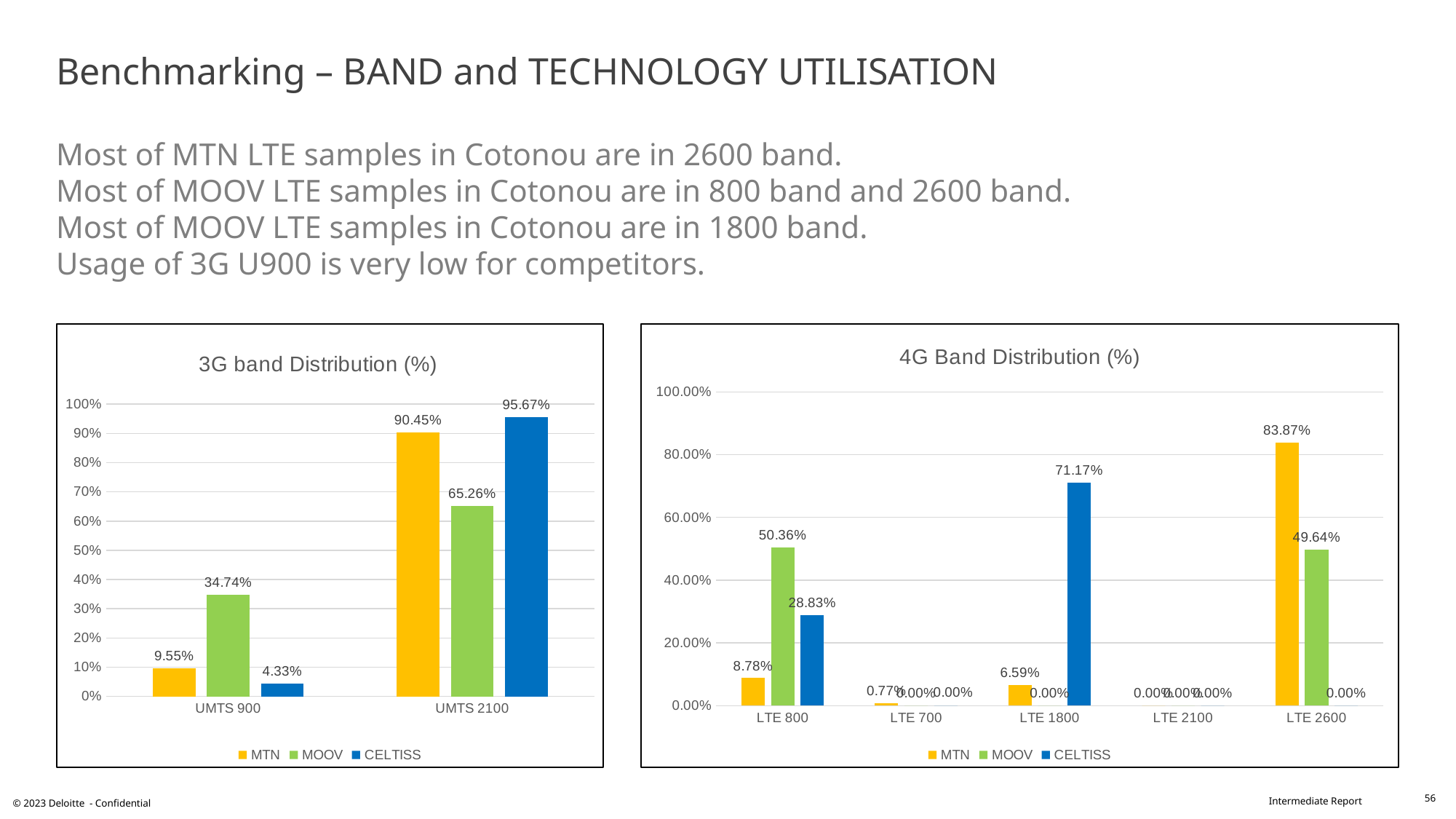
What kind of chart is the 4G Band Distribution (%) chart? Bar chart In the 3G band Distribution (%) chart, what is the difference between the CELTISS and MTN values for UMTS 2100? 5.22% In the 4G Band Distribution (%) chart, is the MTN value for LTE 800 larger or smaller than the CELTISS value for LTE 800? smaller In the 4G Band Distribution (%) chart, what is the value for MTN in LTE 2600? 83.87% In the 4G Band Distribution (%) chart, how many band categories are shown on the x axis? 5 In the 4G Band Distribution (%) chart, which band has the highest MOOV value? LTE 800 In the 3G band Distribution (%) chart, which operator has the lowest value for UMTS 900? CELTISS In the 4G Band Distribution (%) chart, what is the value for CELTISS in LTE 1800? 71.17% In the 3G band Distribution (%) chart, what is the value for MOOV in UMTS 900? 34.74% In the 3G band Distribution (%) chart, which operator has the highest value for UMTS 2100? CELTISS In the 4G Band Distribution (%) chart, what is the difference between the MTN and MOOV values for LTE 2600? 34.23% In the 3G band Distribution (%) chart, how many series does the legend list? 3